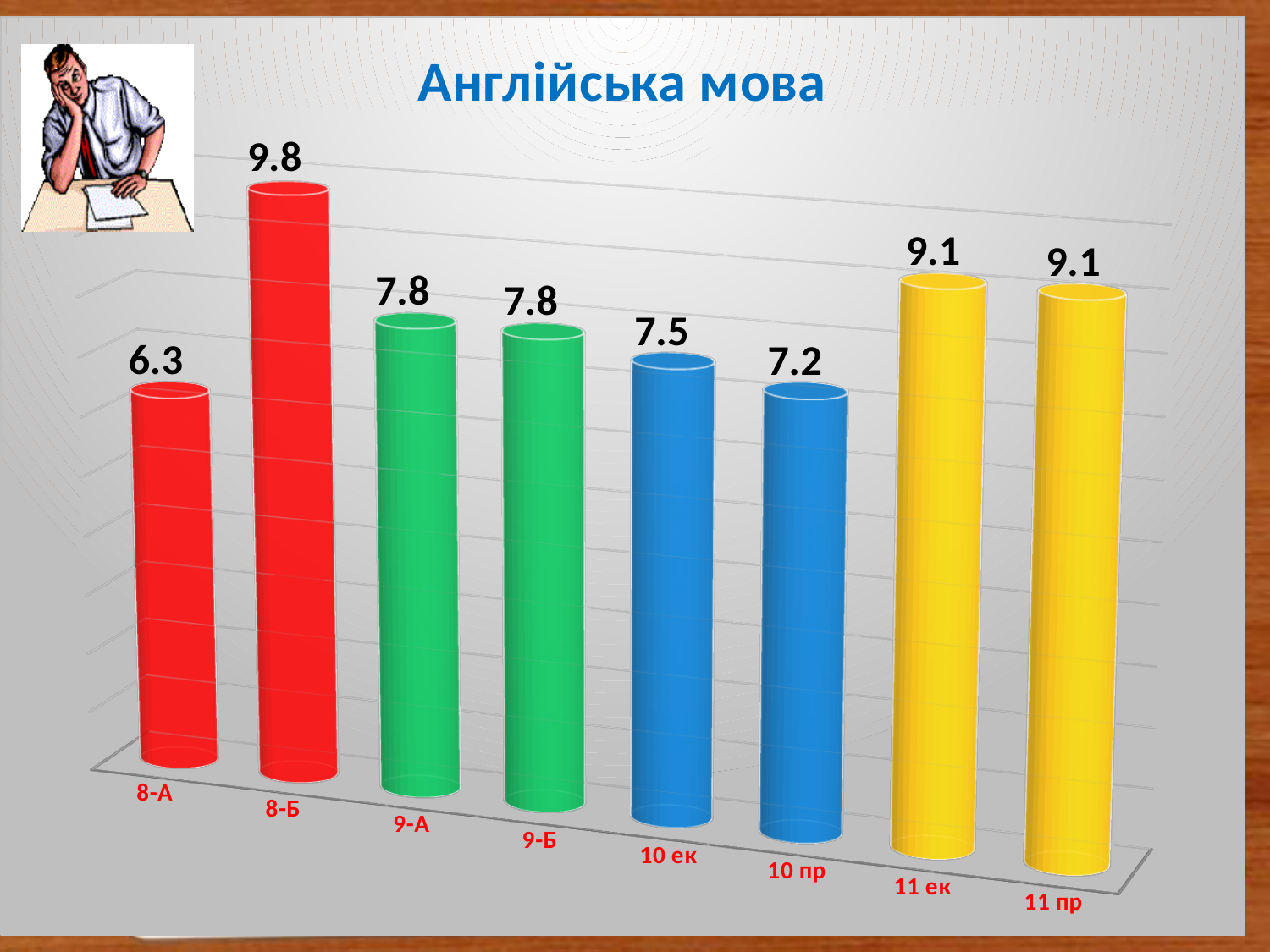
What is the value for 10 пр? 7.2 What is the value for 8-А? 6.3 Which category has the lowest value? 8-А Which is larger, the value for 9-А or the value for 10 ек? 9-А What is the title of the chart? Англійська мова How many categories are shown on the chart? 8 What is the difference between the values for 8-Б and 8-А? 3.5 What colour are the bars for 11 ек and 11 пр? yellow What kind of chart is shown on the slide? bar chart What is the value for 8-Б? 9.8 What is the difference between the values for 11 ек and 10 пр? 1.9 Which category has the highest value? 8-Б